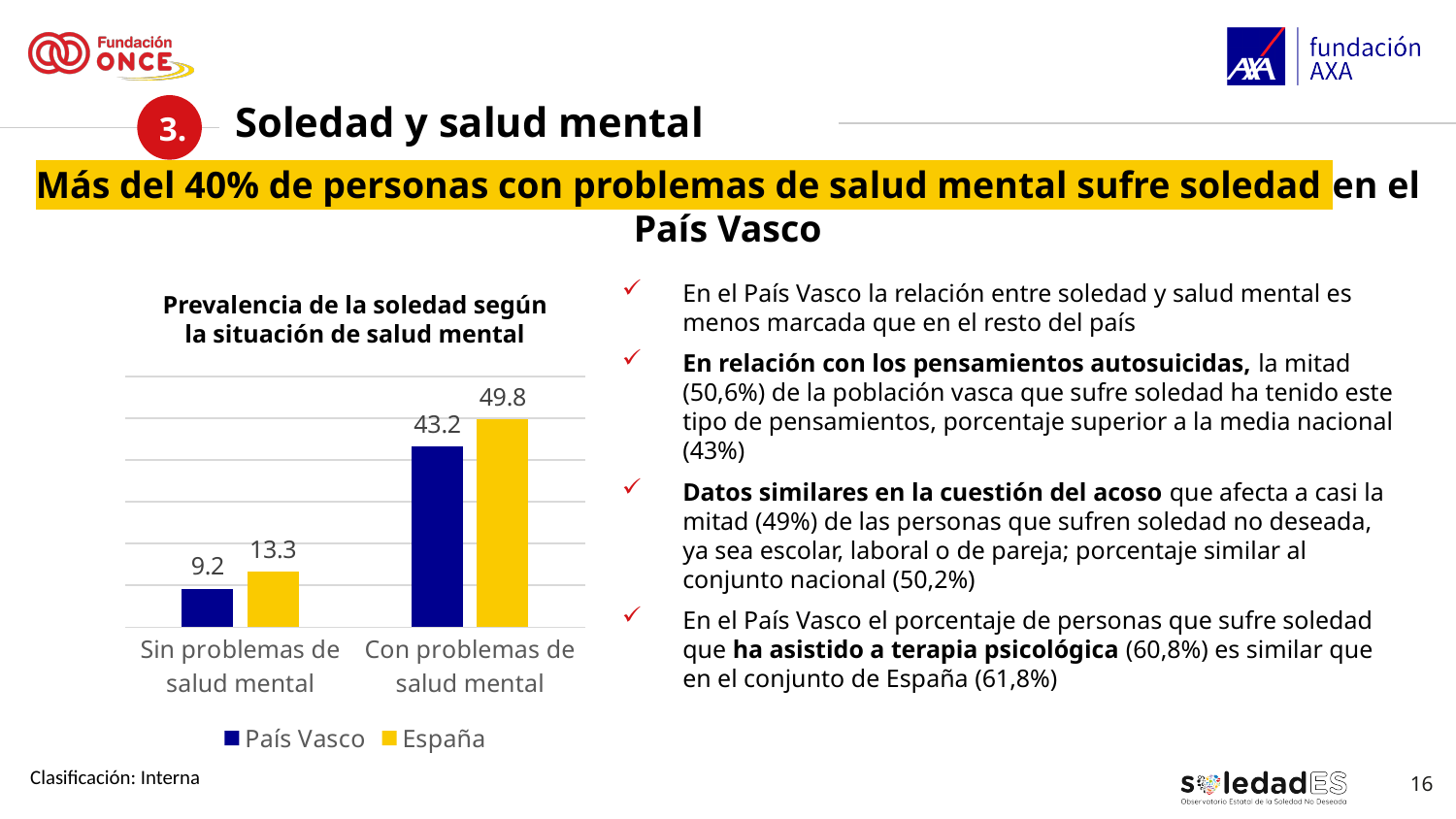
What is the value for País Vasco in the 'Con problemas de salud mental' category? 43.2 What is the difference between the España and País Vasco values in the 'Sin problemas de salud mental' category? 4.1 How many series does the chart legend list? 2 What is the value for España in the 'Con problemas de salud mental' category? 49.8 What is the value for España in the 'Sin problemas de salud mental' category? 13.3 What is the value for País Vasco in the 'Sin problemas de salud mental' category? 9.2 Which is larger in the 'Con problemas de salud mental' category: País Vasco or España? España Which category has the highest value for España? Con problemas de salud mental What kind of chart is shown on the slide? Bar chart How many categories are shown on the x axis of the chart? 2 What is the difference between the España and País Vasco values in the 'Con problemas de salud mental' category? 6.6 Which category has the lowest value for País Vasco? Sin problemas de salud mental